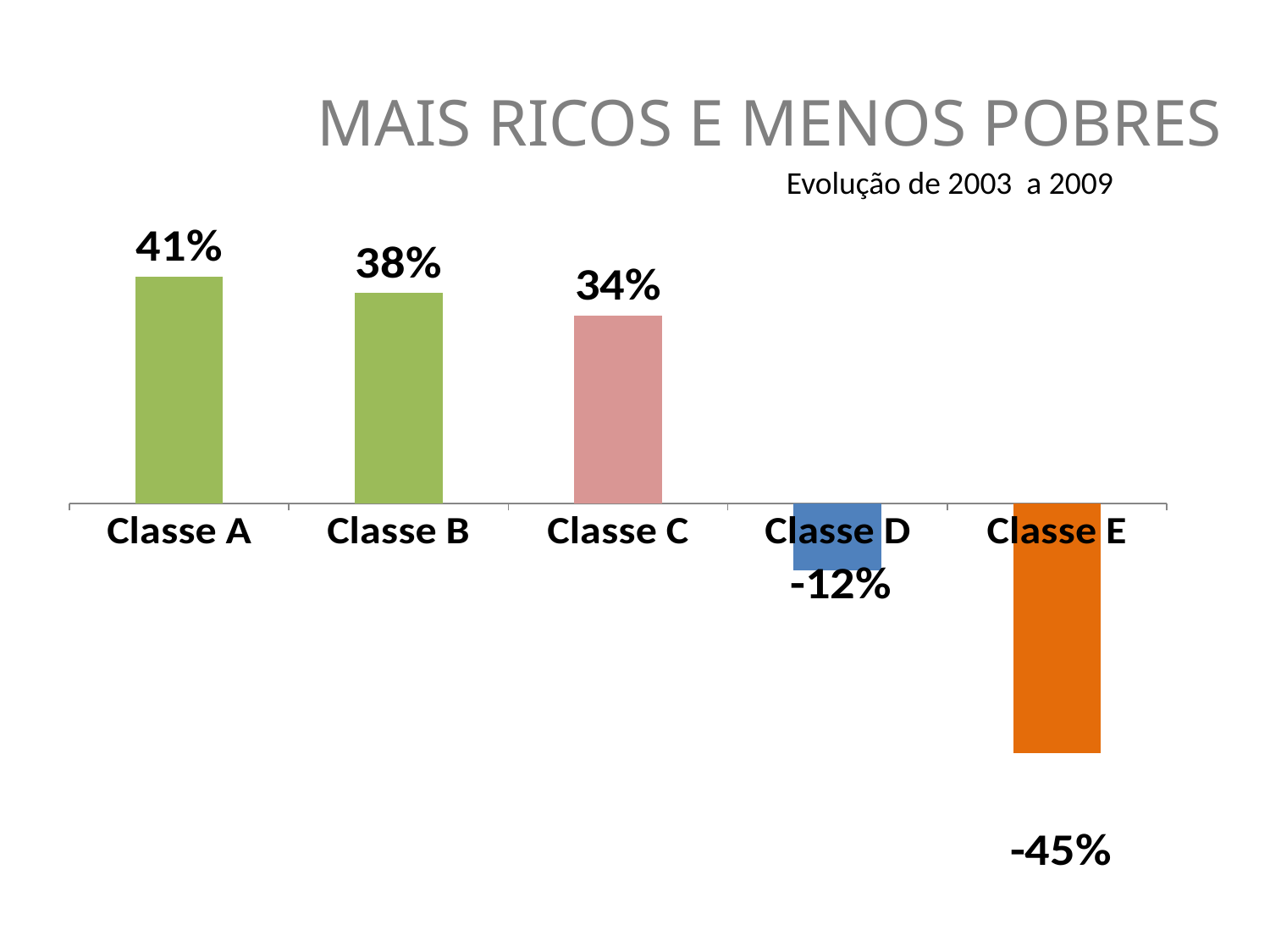
What is the difference between the values for Classe C and Classe D? 46% What is the value for Classe A? 41% What is the value for Classe C? 34% Which class has the lowest value? Classe E What is the difference between the values for Classe A and Classe B? 3% Do the values rise or fall from Classe A to Classe E? Fall What is the value for Classe E? -45% What is the value for Classe D? -12% Which is larger, the value for Classe B or the value for Classe C? Classe B What kind of chart is shown on the slide? Bar chart Which class has the highest value? Classe A How many classes are shown in the chart? 5